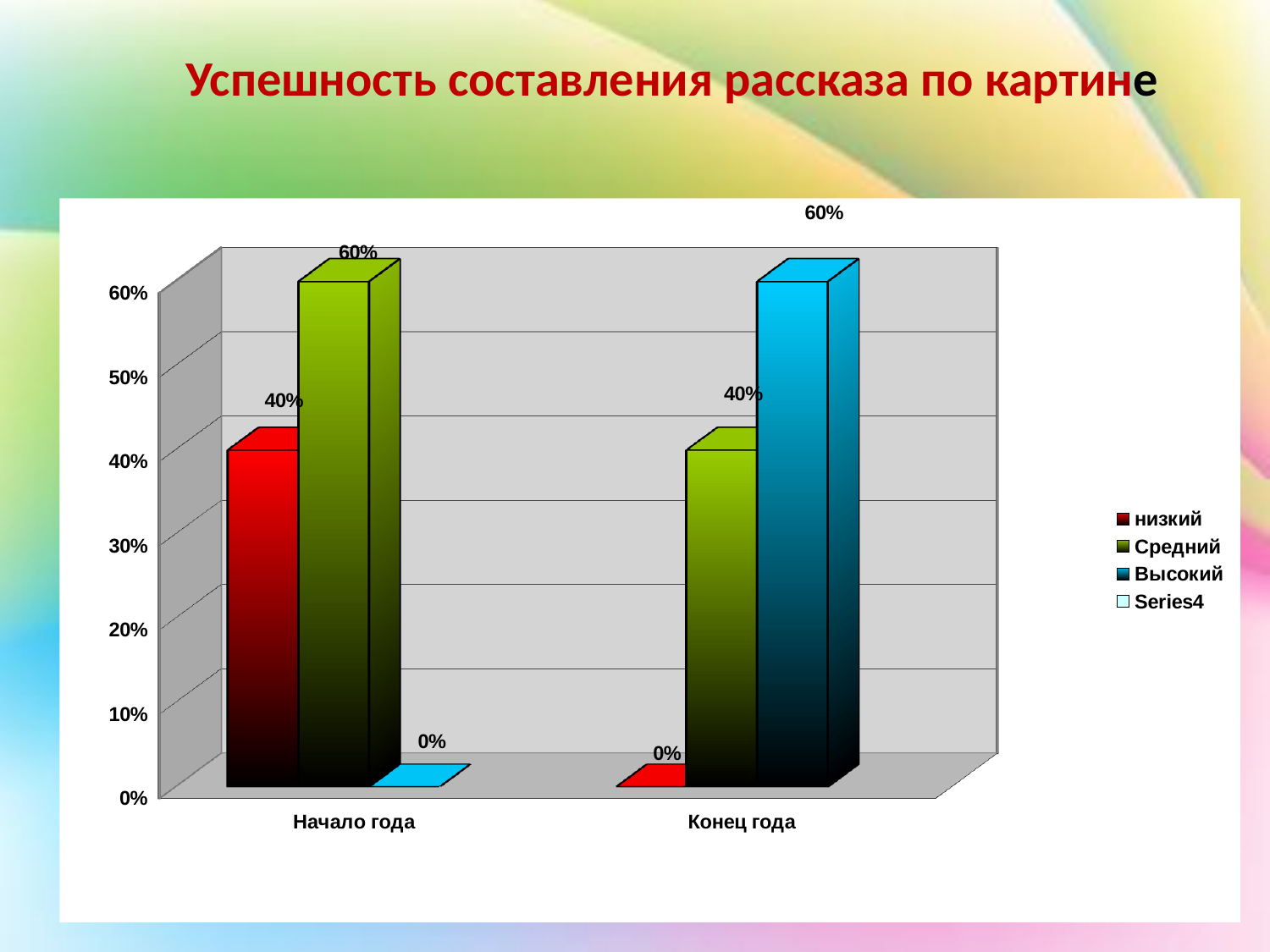
What is the value for низкий at Начало года? 40% What is the value for Средний at Конец года? 40% What is the value for Высокий at Конец года? 60% Which series has the lowest value at Конец года? низкий What is the difference between the Средний value at Начало года and the Средний value at Конец года? 20% What is the value for Средний at Начало года? 60% How many series does the legend list? 4 Which series has the highest value at Начало года? Средний What is the value for низкий at Конец года? 0% Which is larger: the Высокий value at Начало года or the Высокий value at Конец года? Конец года What kind of chart is shown on the slide? Bar chart How many categories are shown on the x axis? 2